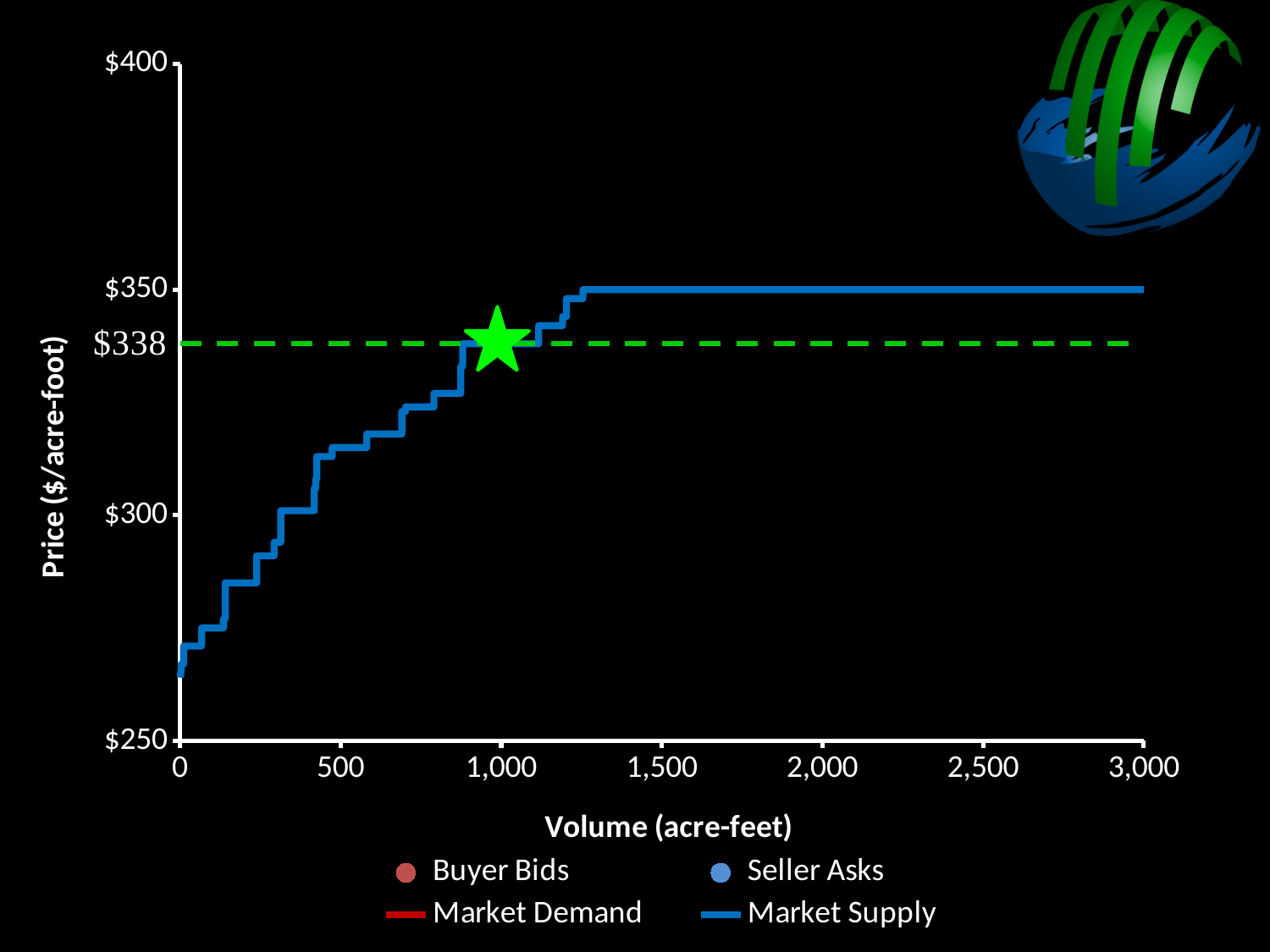
At what price is the dashed green horizontal line drawn? $338 What kind of chart is shown on the slide? line chart Is the Market Supply price at a volume of 1,500 acre-feet greater or less than $338? greater Is the Market Supply price at a volume of 0 acre-feet greater or less than $300? less How many series does the legend list? 4 What is the price of the Market Supply line at a volume of 3,000 acre-feet? $350 What is the title of the x axis? Volume (acre-feet) Is the Market Supply price at a volume of 200 acre-feet greater or less than $300? less Does the Market Supply line rise or fall as volume increases from 0 to 1,500 acre-feet? rise What colour is the Market Supply line in the legend? blue What is the price of the Market Supply line at a volume of 2,000 acre-feet? $350